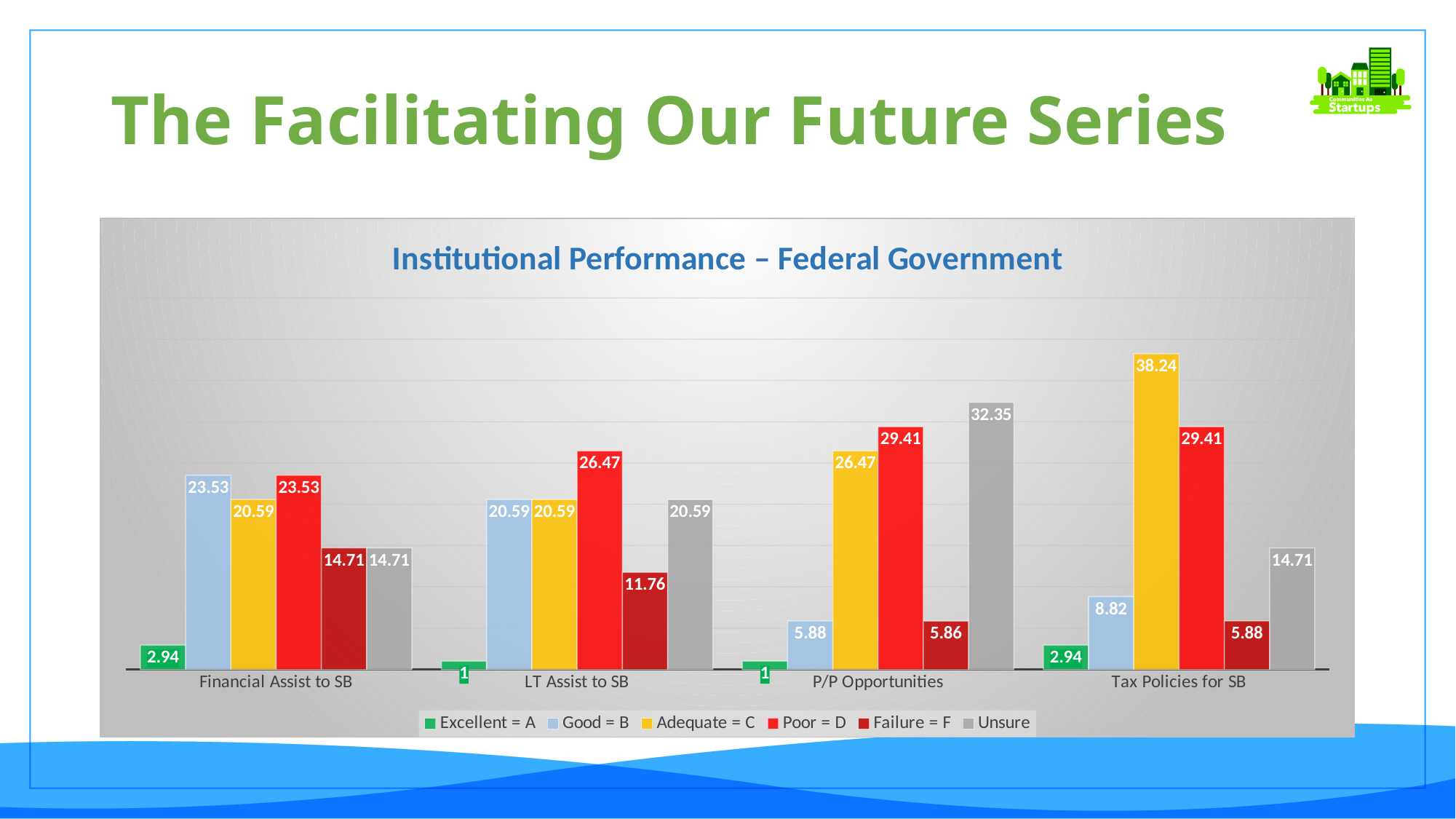
What is the value for Good = B in the Financial Assist to SB category? 23.53 Which series has the highest value in the Tax Policies for SB category? Adequate = C How many series does the legend list? 6 How many categories are shown on the x axis? 4 What is the value for Adequate = C in the Tax Policies for SB category? 38.24 Which series has the lowest value in the P/P Opportunities category? Excellent = A What is the difference between the Poor = D and Failure = F values in the LT Assist to SB category? 14.71 Which is larger in the P/P Opportunities category: Unsure or Poor = D? Unsure What is the title of the chart? Institutional Performance – Federal Government What kind of chart is shown on the slide? Bar chart What is the value for Failure = F in the LT Assist to SB category? 11.76 What is the value for Unsure in the P/P Opportunities category? 32.35